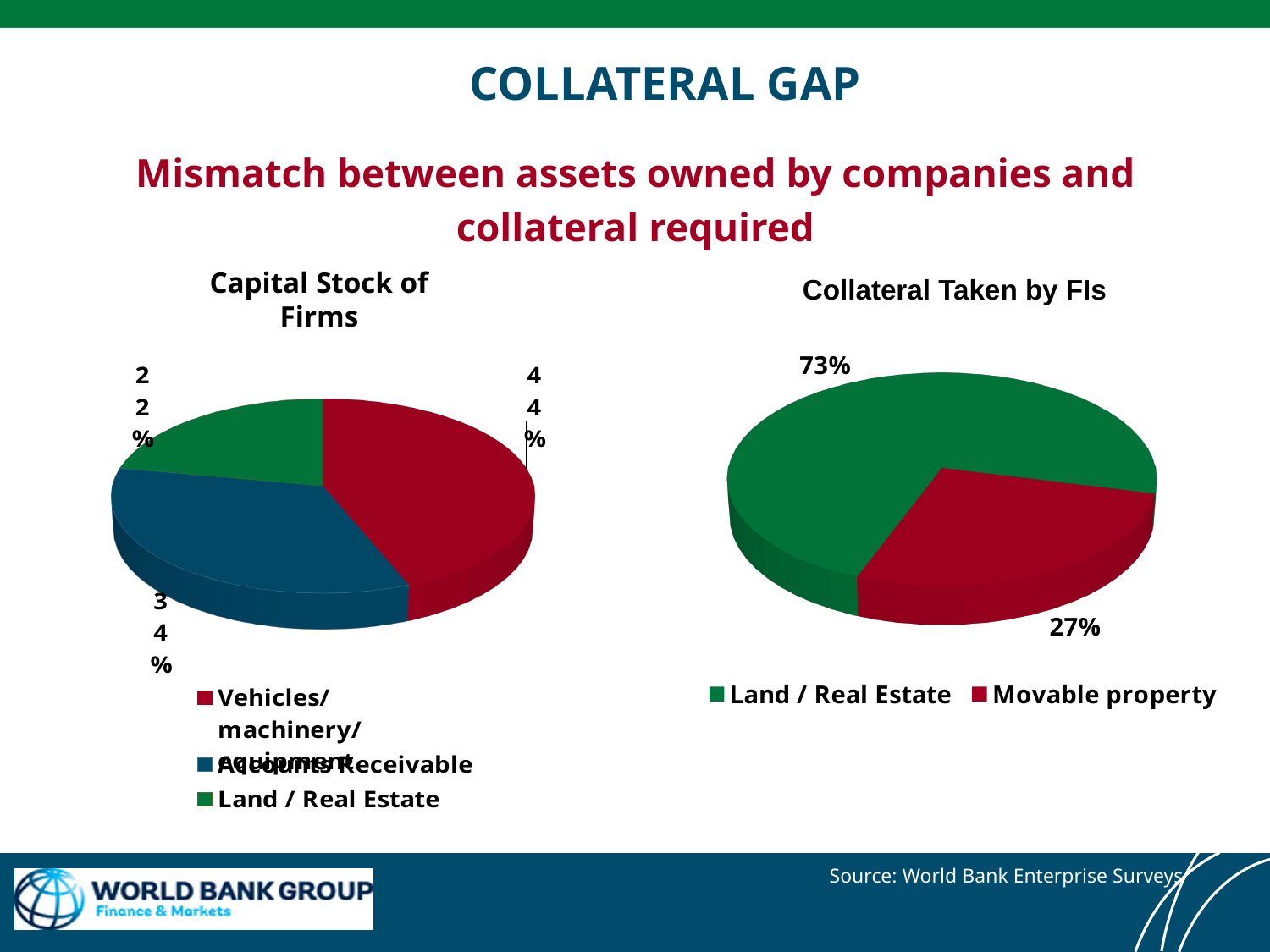
How many slices does the 'Capital Stock of Firms' chart have? 3 In the 'Collateral Taken by FIs' chart, which is larger: Land / Real Estate or Movable property? Land / Real Estate In the 'Capital Stock of Firms' chart, what share is Accounts Receivable? 34% In the 'Collateral Taken by FIs' chart, what share is Land / Real Estate? 73% In the 'Capital Stock of Firms' chart, which category has the smallest share? Land / Real Estate In the 'Capital Stock of Firms' chart, what is the difference in percentage points between Vehicles/machinery/equipment and Accounts Receivable? 10 In the 'Collateral Taken by FIs' chart, what is the difference in percentage points between Land / Real Estate and Movable property? 46 In the 'Capital Stock of Firms' chart, what share is Land / Real Estate? 22% In the 'Capital Stock of Firms' chart, what share is Vehicles/machinery/equipment? 44% In the 'Capital Stock of Firms' chart, which category has the largest share? Vehicles/machinery/equipment In the 'Collateral Taken by FIs' chart, what share is Movable property? 27% What type of chart is 'Collateral Taken by FIs'? Pie chart